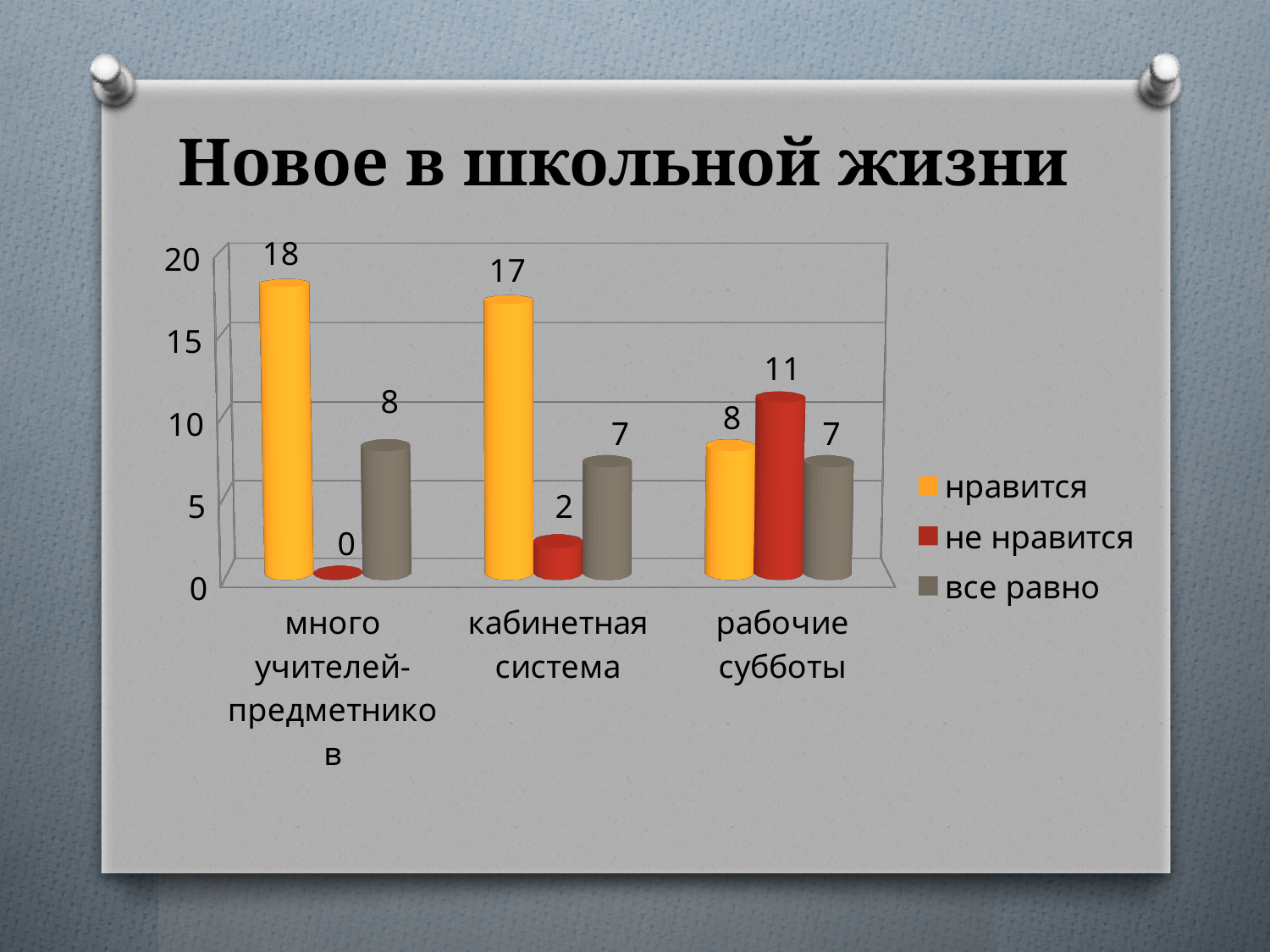
How many series does the legend list? 3 What is the title of the chart? Новое в школьной жизни What kind of chart is shown on the slide? bar chart What is the value for "не нравится" in the "кабинетная система" category? 2 What is the difference between the "нравится" and "все равно" values in the "кабинетная система" category? 10 What is the value for "не нравится" in the "рабочие субботы" category? 11 How many categories are shown on the x axis? 3 What is the value for "нравится" in the "много учителей-предметников" category? 18 Which category has the highest value for "нравится"? много учителей-предметников Which category has the lowest value for "не нравится"? много учителей-предметников In the "рабочие субботы" category, which is larger: "нравится" or "не нравится"? не нравится What is the value for "все равно" in the "рабочие субботы" category? 7